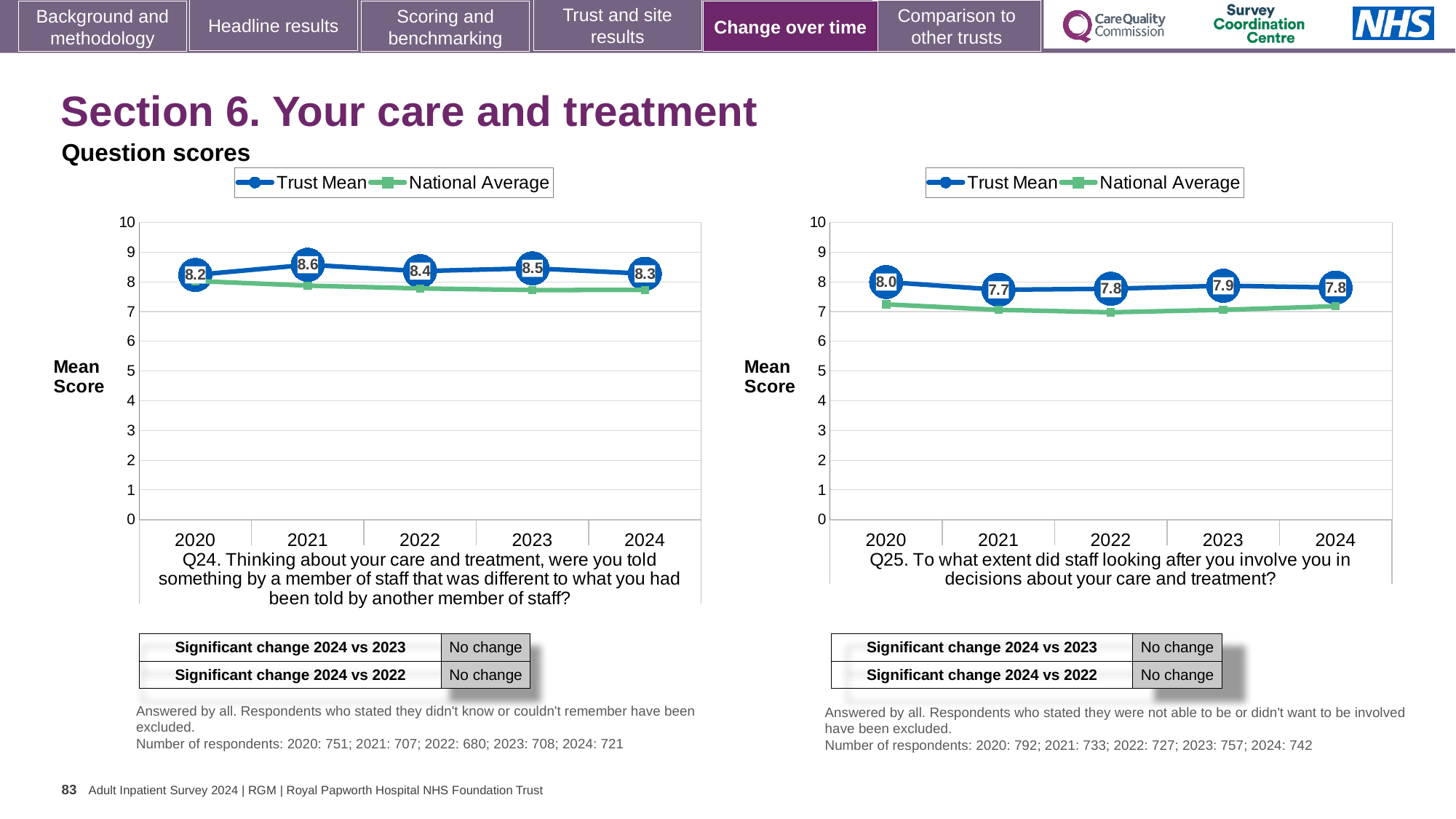
In the Q25 chart on the right, what is the Trust Mean score for 2020? 8.0 How many years are shown on the x axis of the Q24 chart on the left? 5 In the Q25 chart on the right, what is the difference between the Trust Mean scores for 2020 and 2024? 0.2 In the Q24 chart on the left, which year has the highest Trust Mean score? 2021 In the Q24 chart on the left, is the Trust Mean score for 2023 higher or lower than for 2024? higher In the Q25 chart on the right, does the Trust Mean score rise or fall from 2020 to 2021? fall In the Q25 chart on the right, which year has the lowest Trust Mean score? 2021 What type of chart is the Q24 chart on the left? line chart In the Q24 chart on the left, what is the Trust Mean score for 2021? 8.6 How many series does the legend of the Q25 chart on the right list? 2 In the Q25 chart on the right, is the National Average for 2022 greater or less than 8? less In the Q24 chart on the left, what is the difference between the Trust Mean scores for 2021 and 2020? 0.4